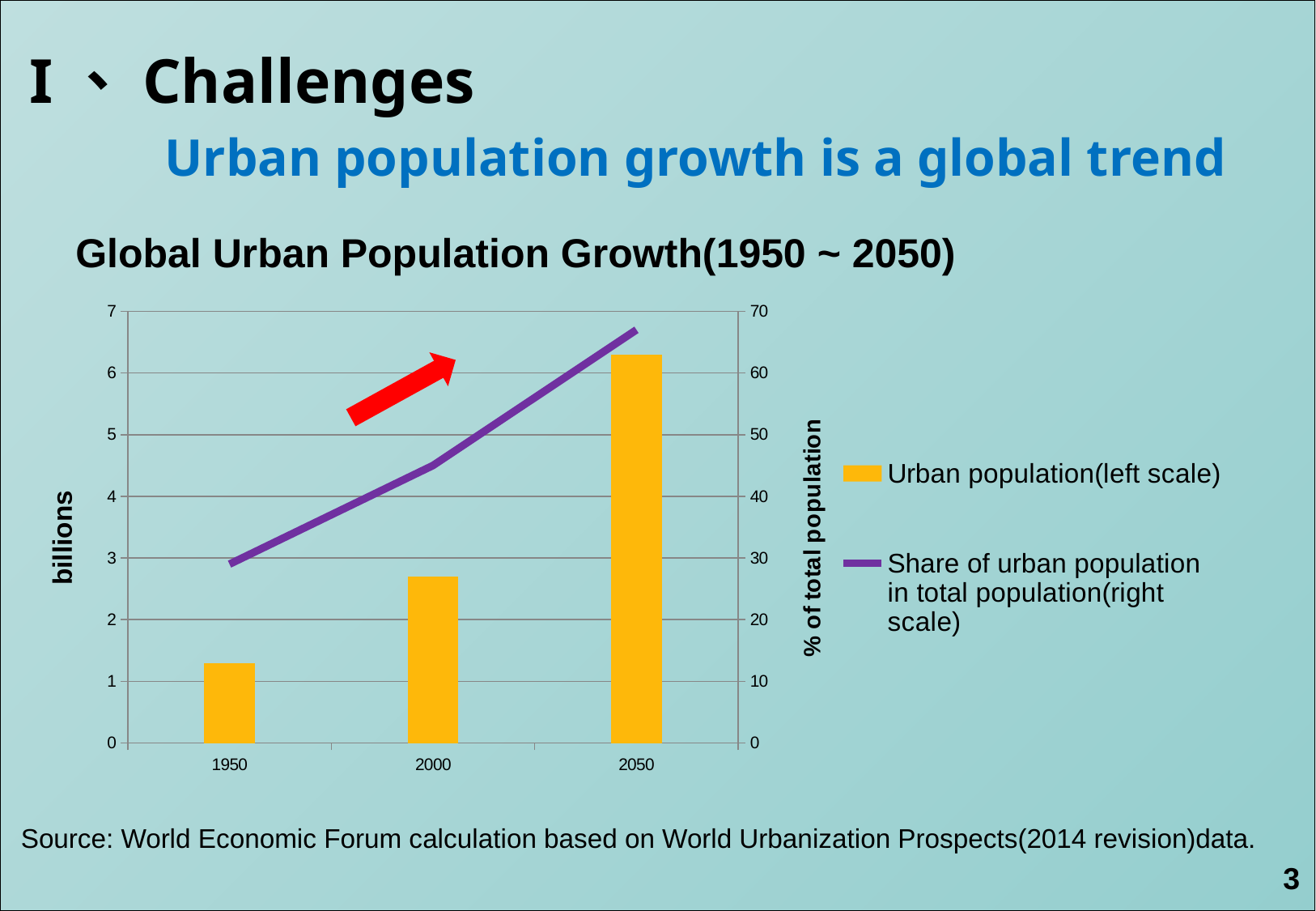
Does the share of urban population in total population rise or fall from 1950 to 2050? rise What is the label of the left vertical axis? billions Which year has the highest urban population bar? 2050 How many years are shown on the x axis? 3 Is the share of urban population in total population for 2050 greater or less than 60? greater What is the title of the chart? Global Urban Population Growth(1950 ~ 2050) Is the urban population bar for 2050 greater or less than 6 billion? greater Which year has a larger urban population bar, 2000 or 2050? 2050 Is the urban population bar for 1950 greater or less than 2 billion? less Which year has the lowest urban population bar? 1950 How many series does the legend list? 2